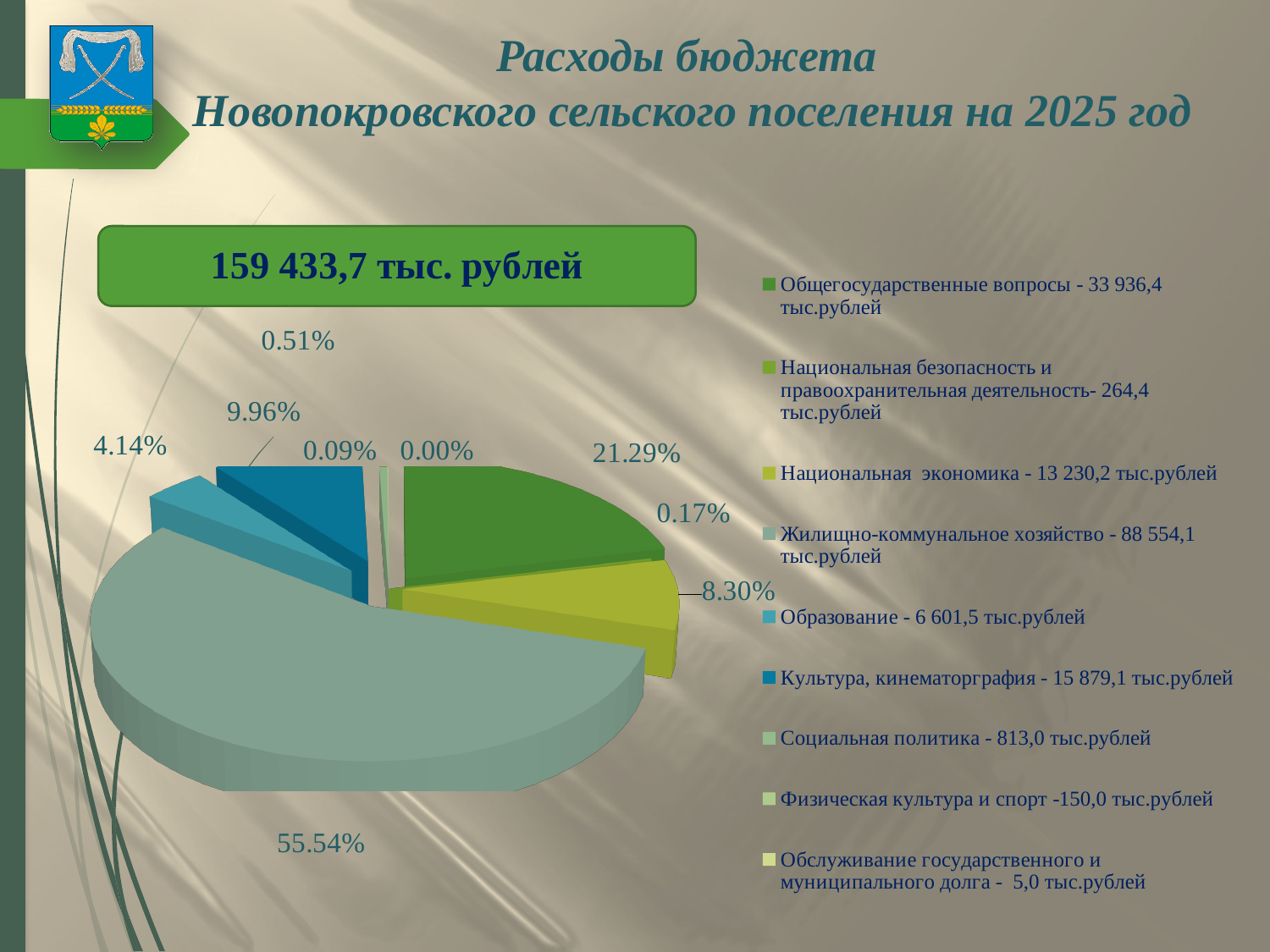
Which is larger: the value for Национальная экономика or the value for Образование? Национальная экономика How many categories does the legend of the pie chart list? 9 What is the value for Обслуживание государственного и муниципального долга according to the legend? 5,0 тыс.рублей Which category has the smallest value in the legend? Обслуживание государственного и муниципального долга What is the difference between the values for Общегосударственные вопросы and Национальная экономика? 20 706,2 тыс.рублей What share of the pie does the largest slice (Жилищно-коммунальное хозяйство) represent? 55.54% What total amount is shown in the green box above the pie chart? 159 433,7 тыс. рублей What is the value for Жилищно-коммунальное хозяйство according to the legend? 88 554,1 тыс.рублей What kind of chart is shown on the slide? Pie chart Which category has the largest share of the pie chart? Жилищно-коммунальное хозяйство What share of the pie does Общегосударственные вопросы represent? 21.29% What is the value for Культура, кинематоргография according to the legend? 15 879,1 тыс.рублей